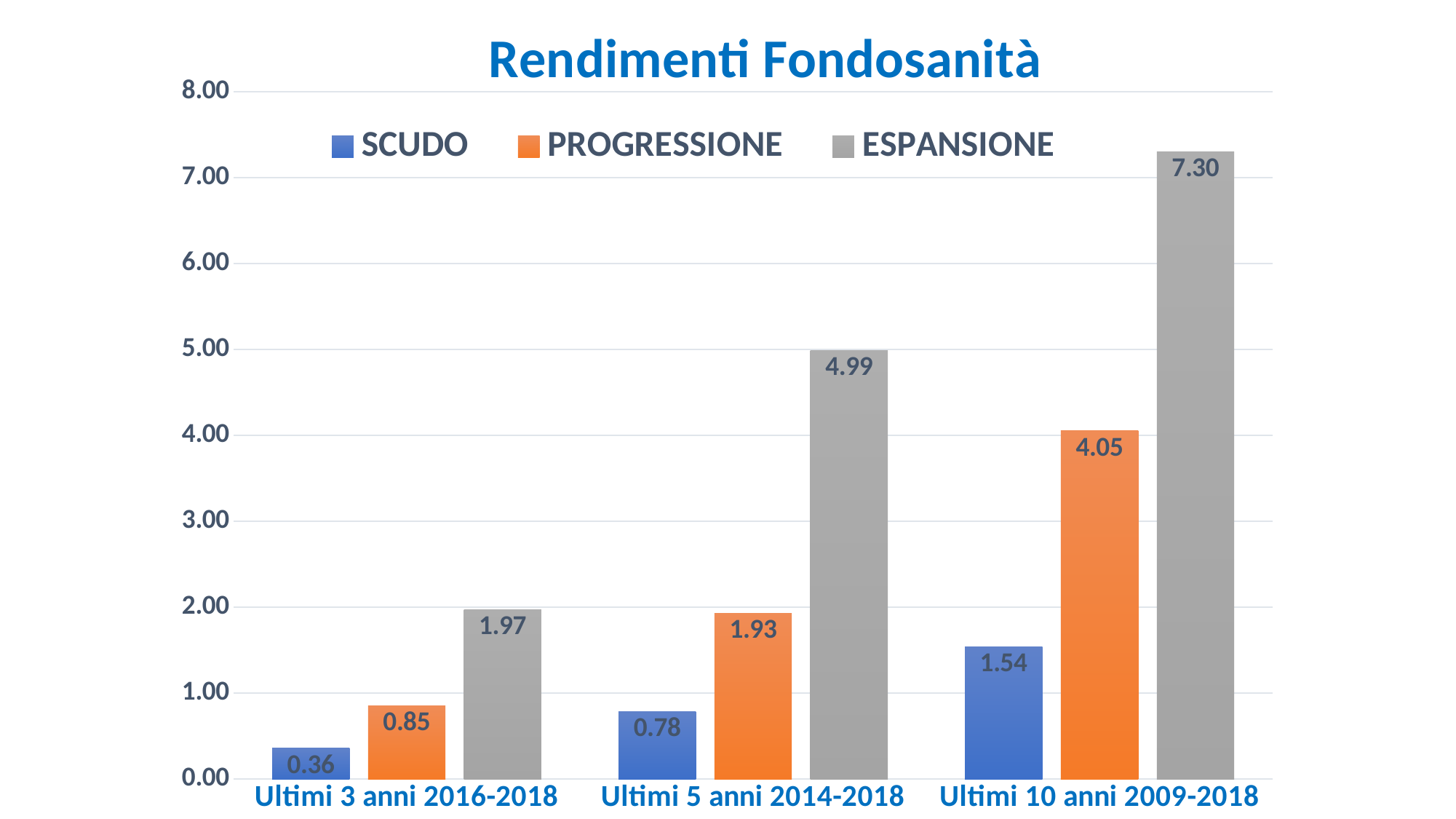
What is the value for SCUDO in Ultimi 3 anni 2016-2018? 0.36 Do the SCUDO values rise or fall from Ultimi 3 anni to Ultimi 10 anni? rise What is the value for ESPANSIONE in Ultimi 10 anni 2009-2018? 7.30 What kind of chart is shown? bar chart Which is larger: PROGRESSIONE in Ultimi 3 anni 2016-2018 or SCUDO in Ultimi 5 anni 2014-2018? PROGRESSIONE in Ultimi 3 anni 2016-2018 What is the difference between ESPANSIONE and PROGRESSIONE in Ultimi 10 anni 2009-2018? 3.25 What is the value for PROGRESSIONE in Ultimi 5 anni 2014-2018? 1.93 Which series has the highest value in Ultimi 5 anni 2014-2018? ESPANSIONE Which series has the lowest value in Ultimi 10 anni 2009-2018? SCUDO How many series does the legend list? 3 Is the value for ESPANSIONE in Ultimi 5 anni 2014-2018 greater or less than 4.00? greater How many categories are shown on the x axis? 3